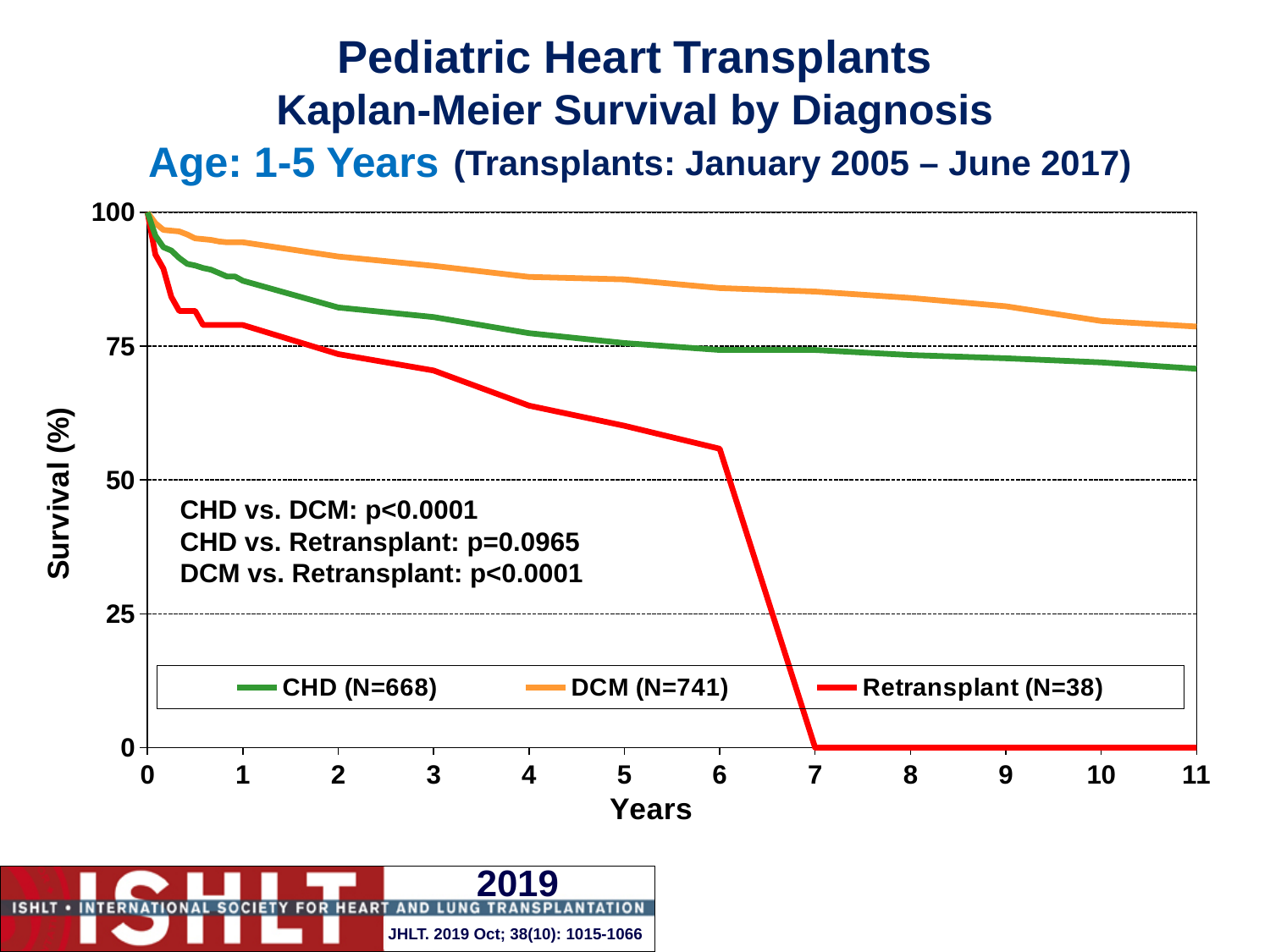
How many series does the legend list? 3 At 3 years, which group has higher survival, CHD or DCM? DCM Which diagnosis group has the lowest survival at 5 years? Retransplant Is the survival for DCM at 5 years greater or less than 75? greater What is the N for the CHD group shown in the legend? 668 Is the survival for Retransplant at 4 years greater or less than 75? less What kind of chart is shown on the slide? line chart Is the survival for CHD at 10 years greater or less than 75? less What is the N for the Retransplant group shown in the legend? 38 What is the survival (%) for the Retransplant group at 8 years? 0 Do the survival curves rise or fall as years increase? fall Which diagnosis group has the highest survival at 5 years? DCM